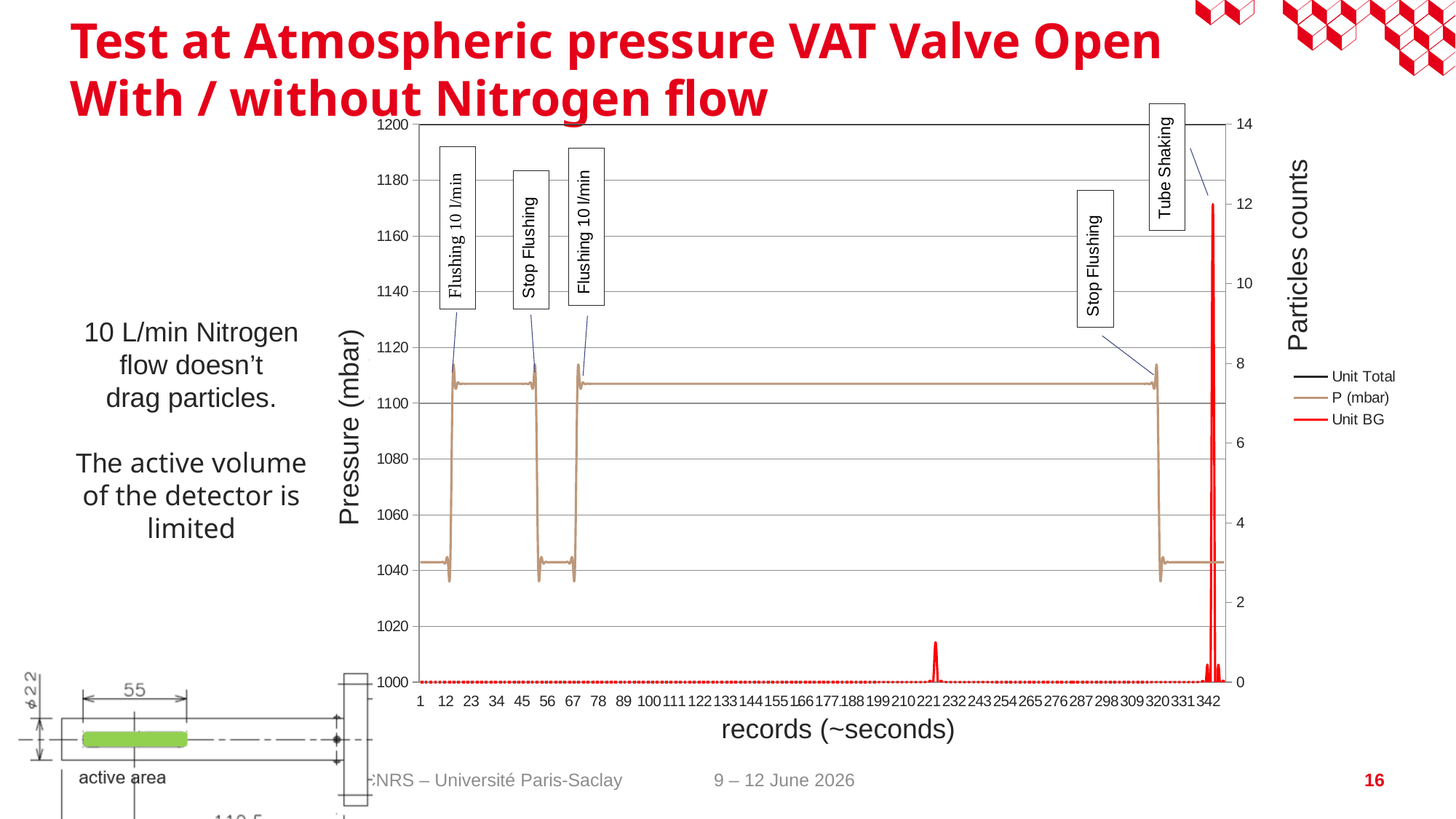
Is the pressure (P (mbar)) before the first flushing starts greater or less than 1060 mbar? less What is the title of the left vertical axis of the chart? Pressure (mbar) Does the pressure (P (mbar)) rise or fall when flushing is stopped? fall How many series does the chart legend list? 3 What are the three series named in the chart legend? Unit Total, P (mbar), Unit BG What is the maximum value shown on the right vertical axis (Particles counts)? 14 Is the small Unit BG particle count peak near record 221 greater or less than 4? less Is the pressure (P (mbar)) higher during the 'Flushing 10 l/min' periods or during the 'Stop Flushing' periods? Flushing 10 l/min What kind of chart is shown on the slide? line chart Is the peak of the Unit BG particle count during the 'Tube Shaking' event greater or less than 10? greater